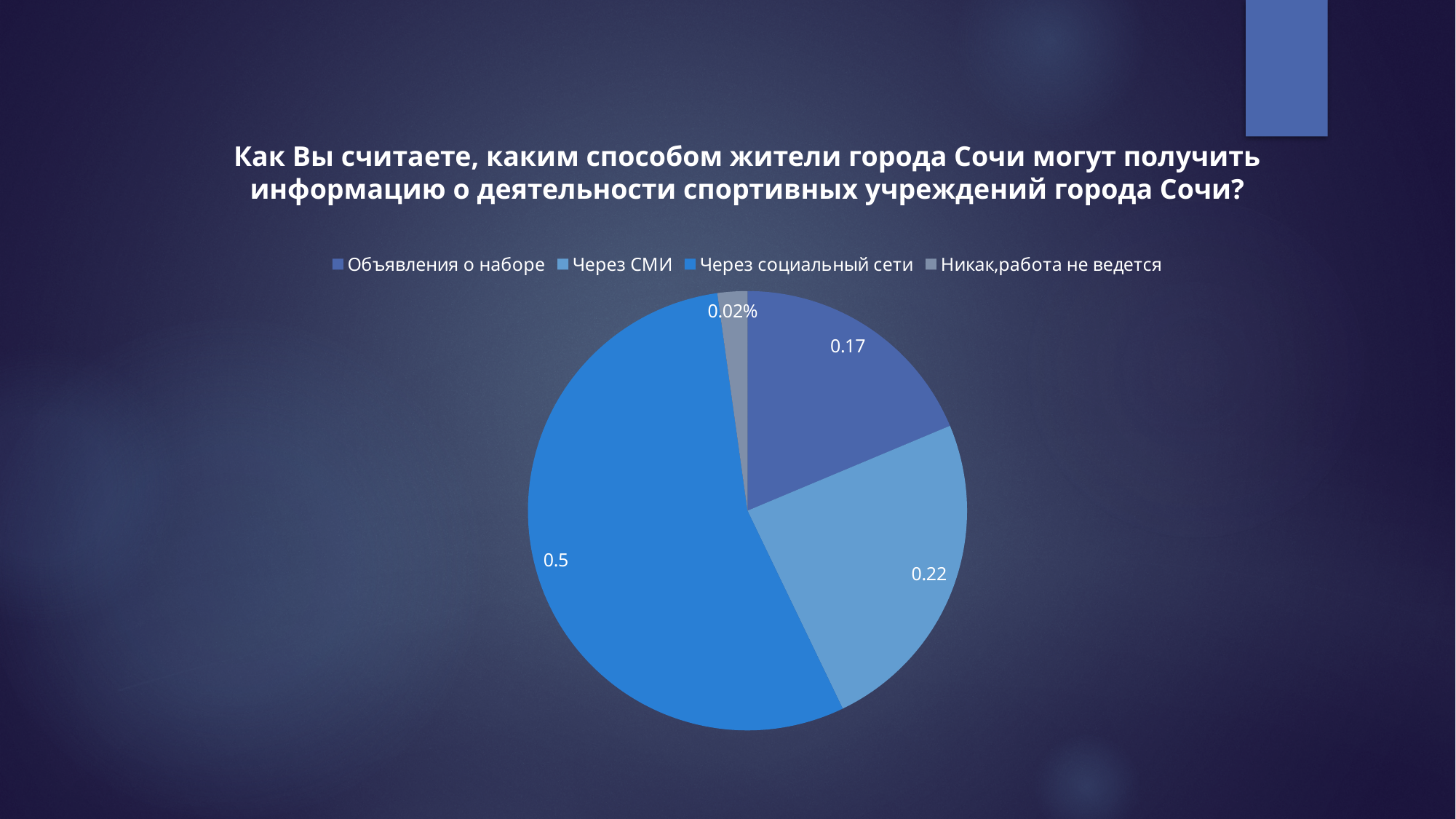
What is the value shown for the slice "Через СМИ"? 0.22 What is the difference between the values for "Через социальный сети" and "Через СМИ"? 0.28 Which is larger, the slice for "Через СМИ" or the slice for "Объявления о наборе"? Через СМИ What is the difference between the values for "Через СМИ" and "Объявления о наборе"? 0.05 What is the value shown for the slice "Объявления о наборе"? 0.17 How many entries does the legend list? 4 What is the value shown for the slice "Никак,работа не ведется"? 0.02% Which category has the largest slice of the pie? Через социальный сети What is the value shown for the slice "Через социальный сети"? 0.5 Which category has the smallest slice of the pie? Никак,работа не ведется What kind of chart is shown on the slide? pie chart How many slices does the pie chart have? 4